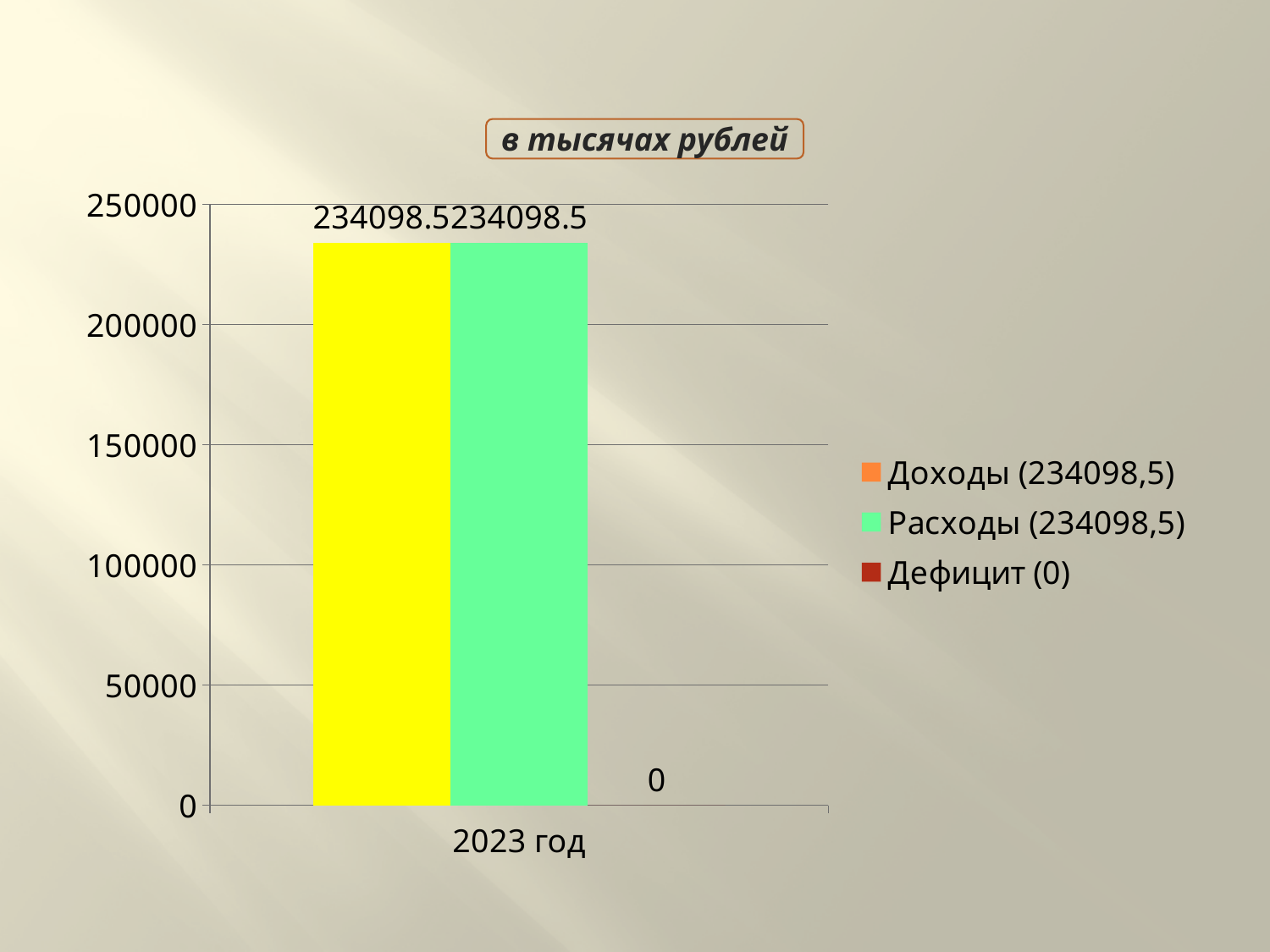
How many series does the legend list? 3 How many categories are shown on the x axis? 1 What is the title of the chart? в тысячах рублей Is the value for Расходы in 2023 год greater or less than 250000? less Is the value for Доходы in 2023 год greater or less than 200000? greater What is the value of Дефицит for 2023 год? 0 What is the value of Расходы for 2023 год? 234098.5 What is the difference between Доходы and Расходы for 2023 год? 0 What kind of chart is shown on the slide? bar chart Which series has the lowest value for 2023 год? Дефицит What category label is shown on the x axis? 2023 год What is the value of Доходы for 2023 год? 234098.5